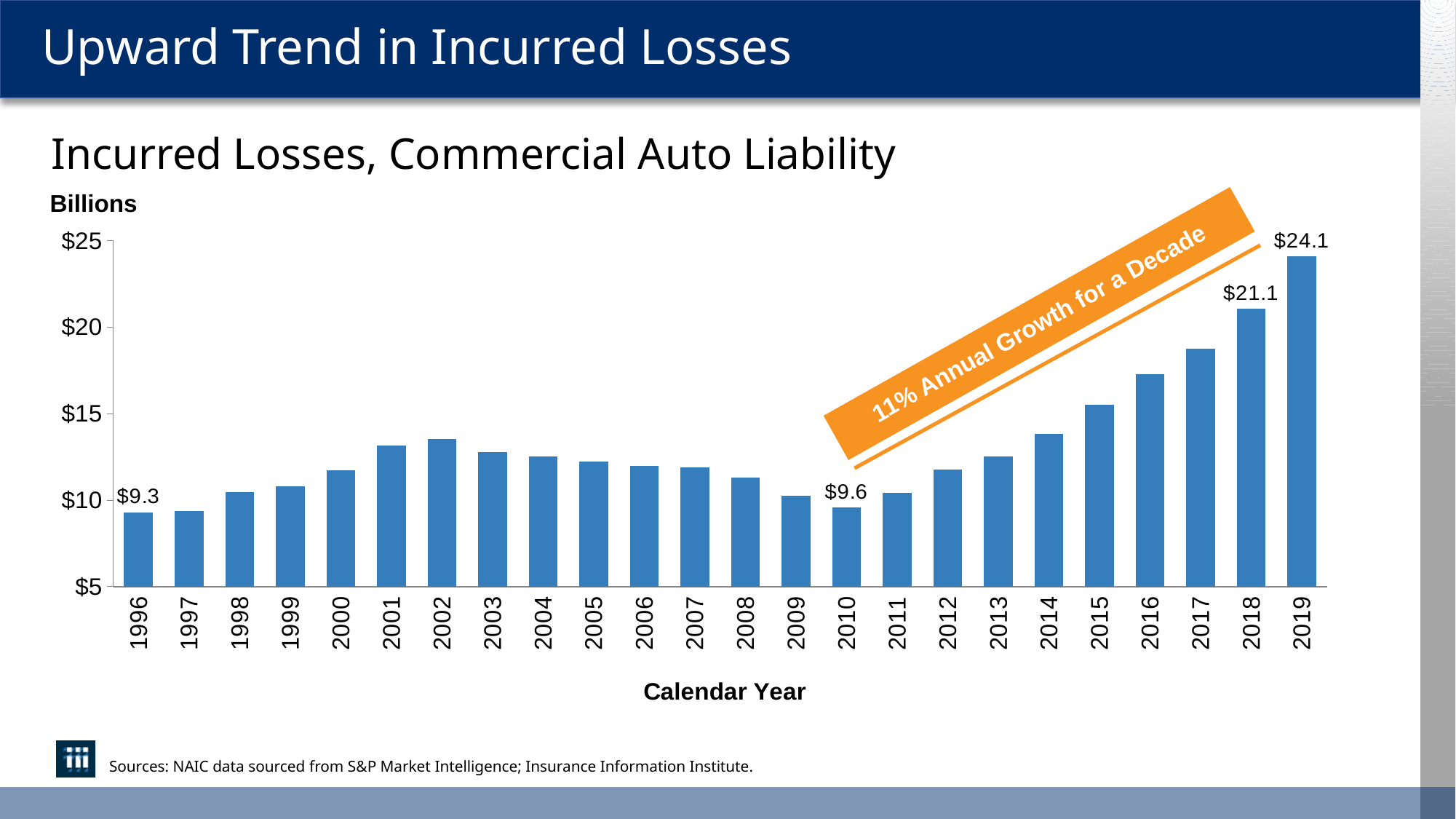
Do the values rise or fall from 2010 to 2019? rise What is the value for 2018? $21.1 What kind of chart is shown on the slide? bar chart What is the difference between the values for 2019 and 2018? $3.0 Is the value for 2002 greater or less than $15? less How many years are shown on the x axis? 24 What is the value for 2010? $9.6 What is the value for 2019? $24.1 What is the value for 1996? $9.3 Which year has the highest incurred losses? 2019 Is the value for 2016 greater or less than $15? greater Which is larger, the value for 2018 or the value for 2010? 2018